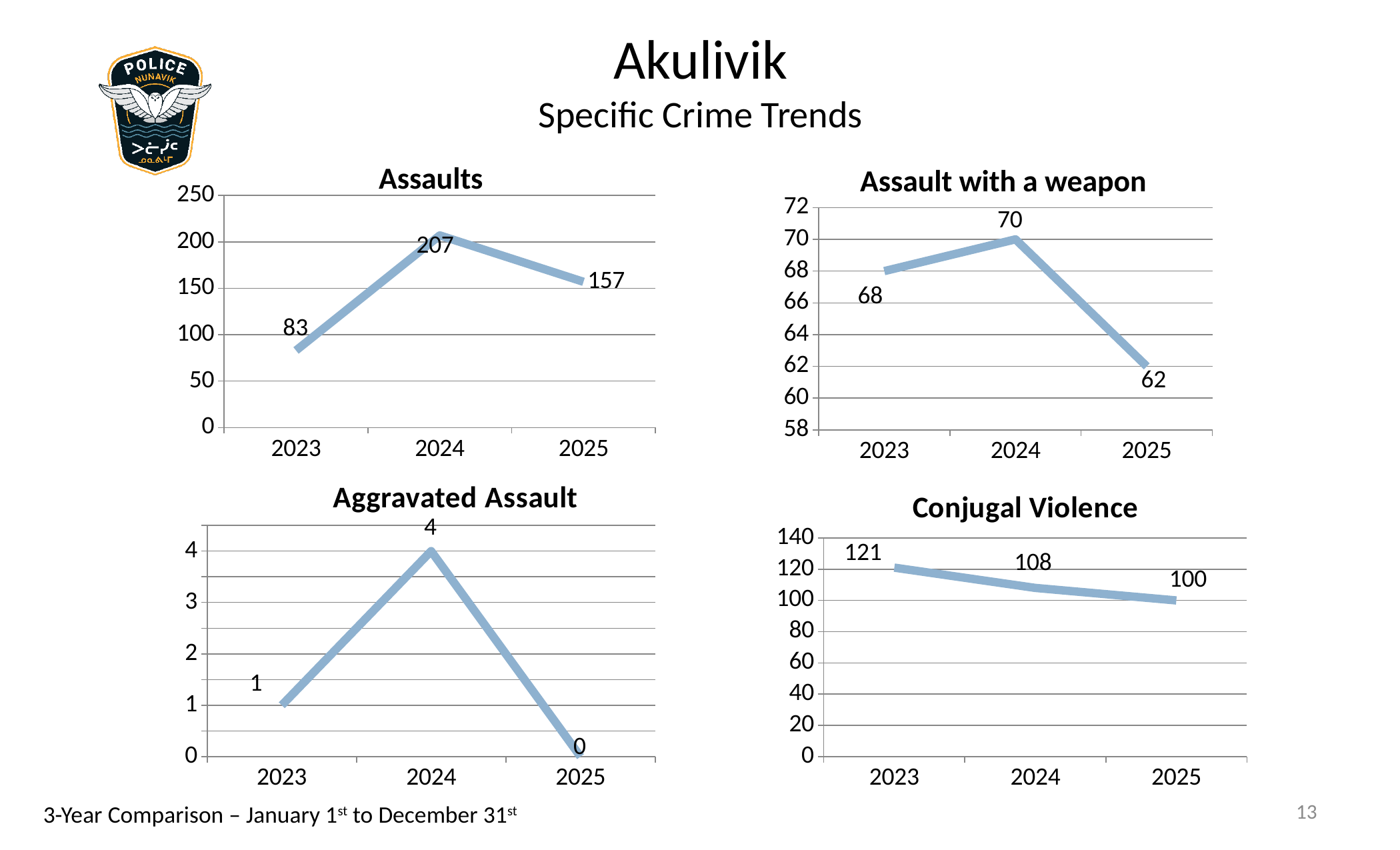
In the Aggravated Assault chart, what is the value for 2025? 0 In the Assault with a weapon chart, what is the value for 2025? 62 In the Assault with a weapon chart, which year has the highest value? 2024 In the Assaults chart, what is the value for 2024? 207 How many data points are plotted in the Conjugal Violence chart? 3 In the Assault with a weapon chart, is the value for 2023 larger or smaller than the value for 2025? larger In the Conjugal Violence chart, do the values rise or fall from 2023 to 2025? fall What kind of chart is the Assaults chart? line chart In the Assaults chart, what is the difference between the 2024 and 2025 values? 50 In the Conjugal Violence chart, what is the difference between the 2023 and 2025 values? 21 In the Assaults chart, which year has the lowest value? 2023 In the Aggravated Assault chart, what is the value for 2024? 4